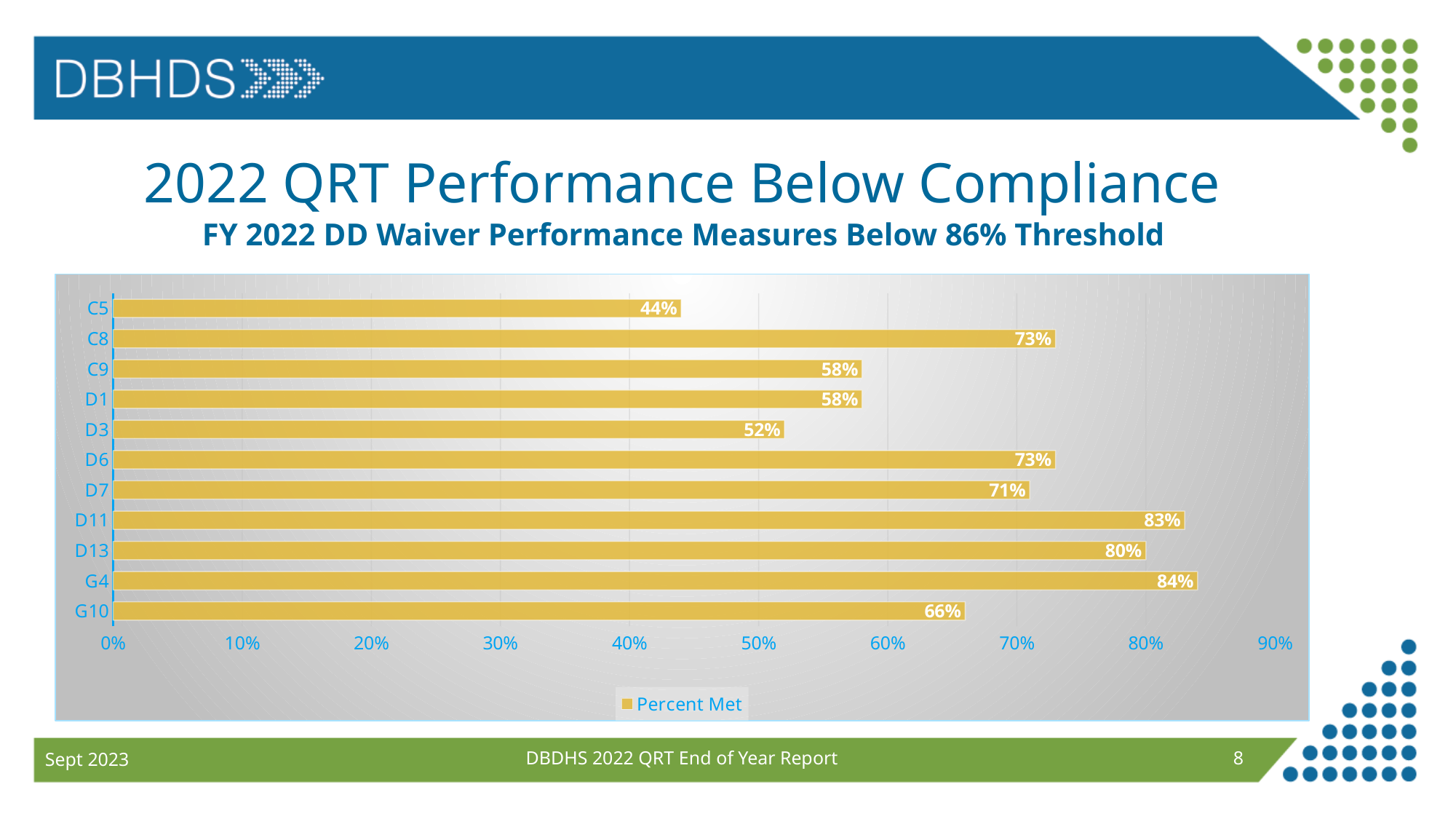
Which measure has the lowest Percent Met? C5 What is the Percent Met value for D11? 83% What is the difference in Percent Met between G4 and C5? 40% Which has a higher Percent Met, D3 or D7? D7 Which measure has the highest Percent Met? G4 What is the name of the series shown in the legend? Percent Met What kind of chart is shown on the slide? Bar chart What is the Percent Met value for G10? 66% How many series does the legend list? 1 How many measures are shown in the chart? 11 What is the Percent Met value for C5? 44% Is the value for D13 greater or less than 70%? greater